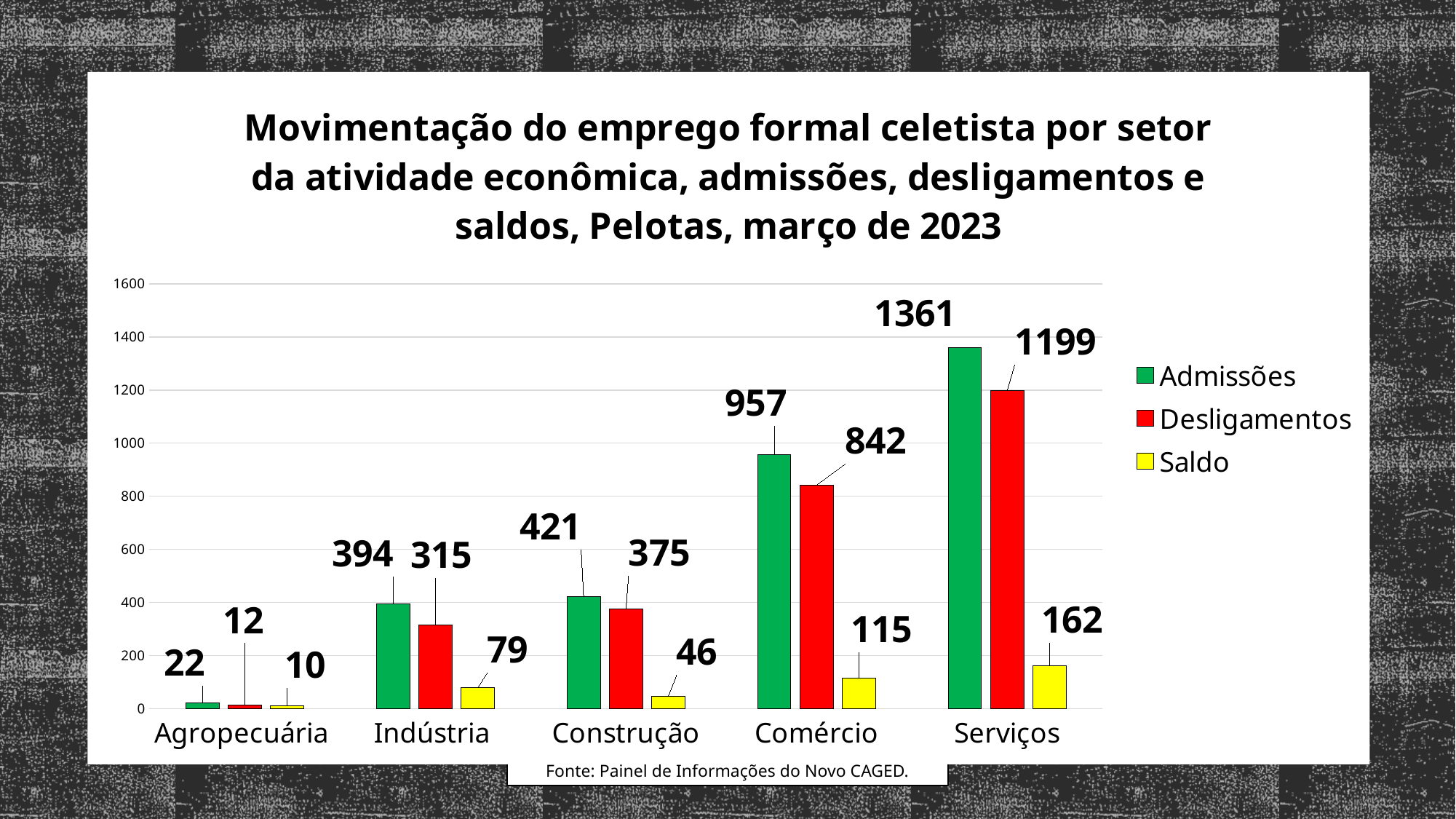
How many sectors are shown on the x axis? 5 Is the Desligamentos value for Serviços greater or less than 1000? greater What is the difference between Admissões and Desligamentos for Construção? 46 What is the Saldo value for Indústria? 79 Which sector has the lowest Saldo value? Agropecuária What is the Admissões value for Serviços? 1361 What is the Desligamentos value for Comércio? 842 Which sector has the highest Admissões value? Serviços What kind of chart is shown on the slide? Bar chart How many series does the legend list? 3 Which is larger for Indústria: Admissões or Desligamentos? Admissões What colour represents the Saldo series in the legend? Yellow